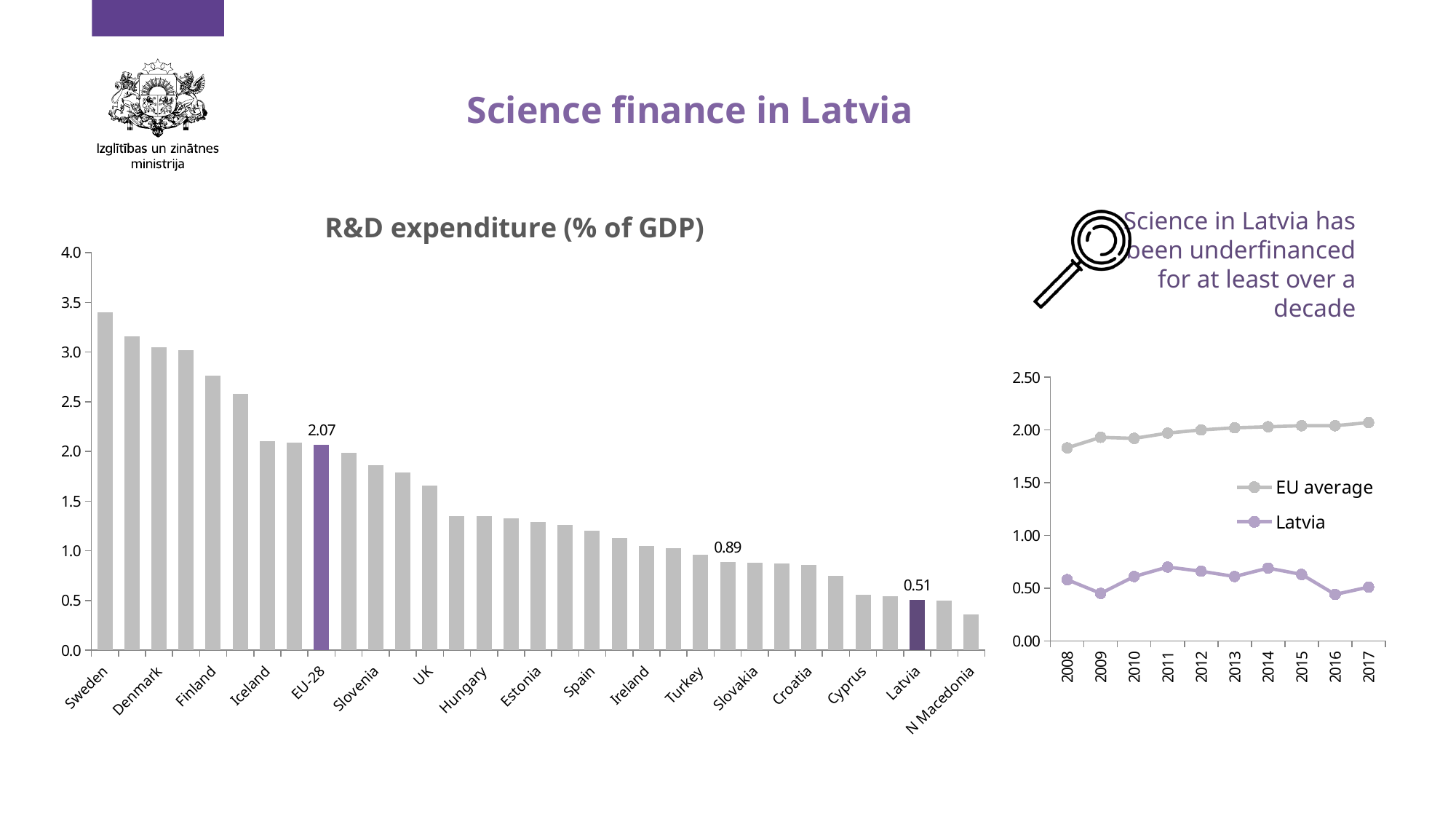
On the R&D expenditure (% of GDP) chart, which country has the highest value? Sweden On the line chart on the right, how many years are plotted along the x axis? 10 On the R&D expenditure (% of GDP) chart, what is the value for EU-28? 2.07 How many series does the legend of the line chart on the right list? 2 On the R&D expenditure (% of GDP) chart, which is larger, the value for Finland or the value for Iceland? Finland On the R&D expenditure (% of GDP) chart, is the value for Sweden greater or less than 3.0? greater On the line chart on the right, does the EU average series rise or fall from 2008 to 2017? rise On the R&D expenditure (% of GDP) chart, what is the difference between the EU-28 value and the Latvia value? 1.56 On the R&D expenditure (% of GDP) chart, is the value for Cyprus greater or less than 1.0? less On the R&D expenditure (% of GDP) chart, what is the value for Latvia? 0.51 On the R&D expenditure (% of GDP) chart, which country has the lowest value? N Macedonia What kind of chart is the R&D expenditure (% of GDP) chart? bar chart